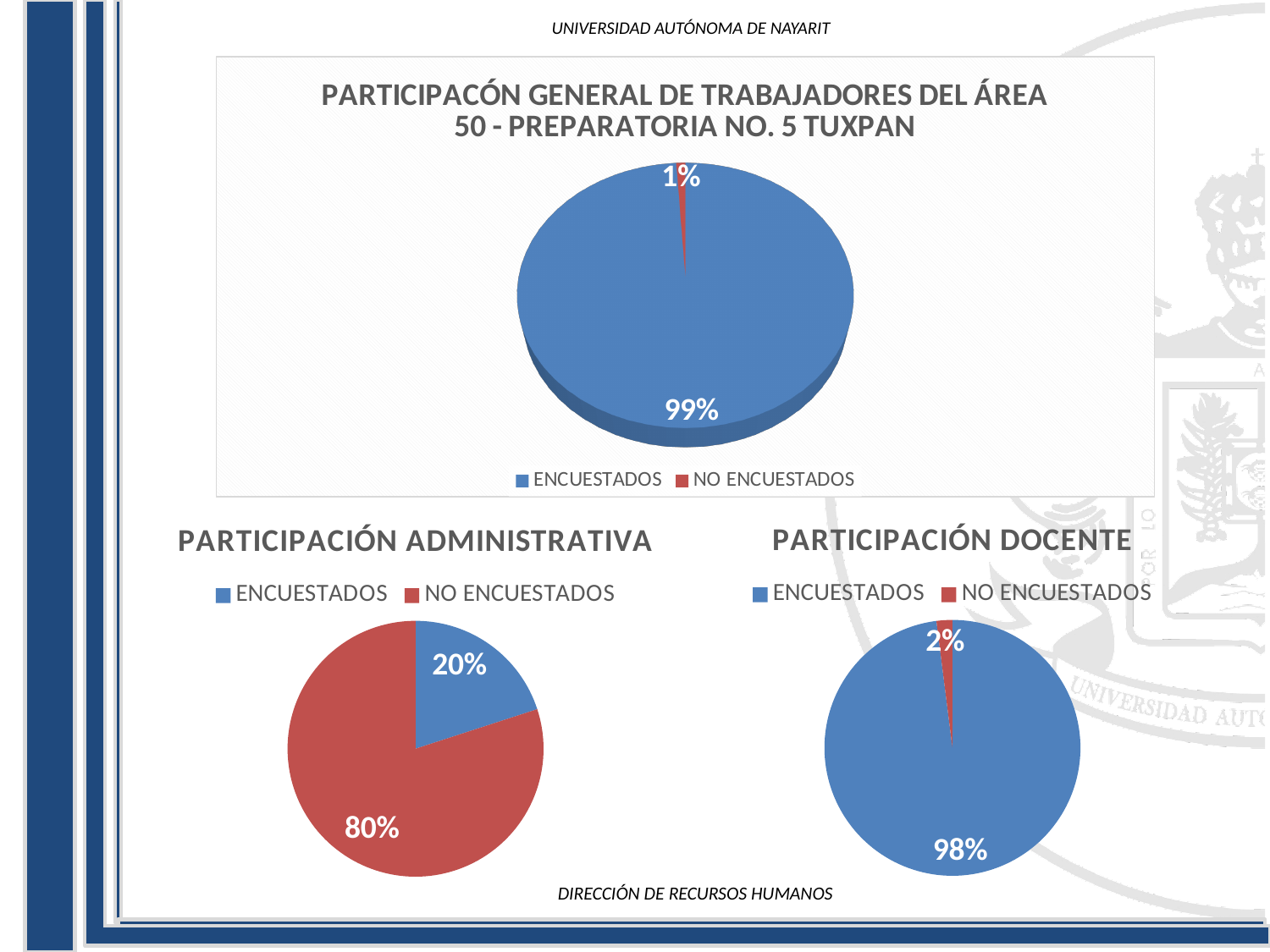
What type of chart is the PARTICIPACIÓN DOCENTE chart? Pie chart Which is larger in the PARTICIPACIÓN DOCENTE chart: ENCUESTADOS or NO ENCUESTADOS? ENCUESTADOS In the PARTICIPACIÓN DOCENTE chart, what share is NO ENCUESTADOS? 2% In the PARTICIPACIÓN DOCENTE chart, which category has the smallest slice? NO ENCUESTADOS In the PARTICIPACIÓN ADMINISTRATIVA chart, what share is NO ENCUESTADOS? 80% In the top chart (PARTICIPACÓN GENERAL DE TRABAJADORES DEL ÁREA 50 - PREPARATORIA NO. 5 TUXPAN), what share is ENCUESTADOS? 99% How many entries does the legend of the PARTICIPACIÓN ADMINISTRATIVA chart list? 2 In the PARTICIPACIÓN ADMINISTRATIVA chart, which category has the largest slice? NO ENCUESTADOS In the PARTICIPACIÓN ADMINISTRATIVA chart, what is the difference between the NO ENCUESTADOS and ENCUESTADOS shares? 60%